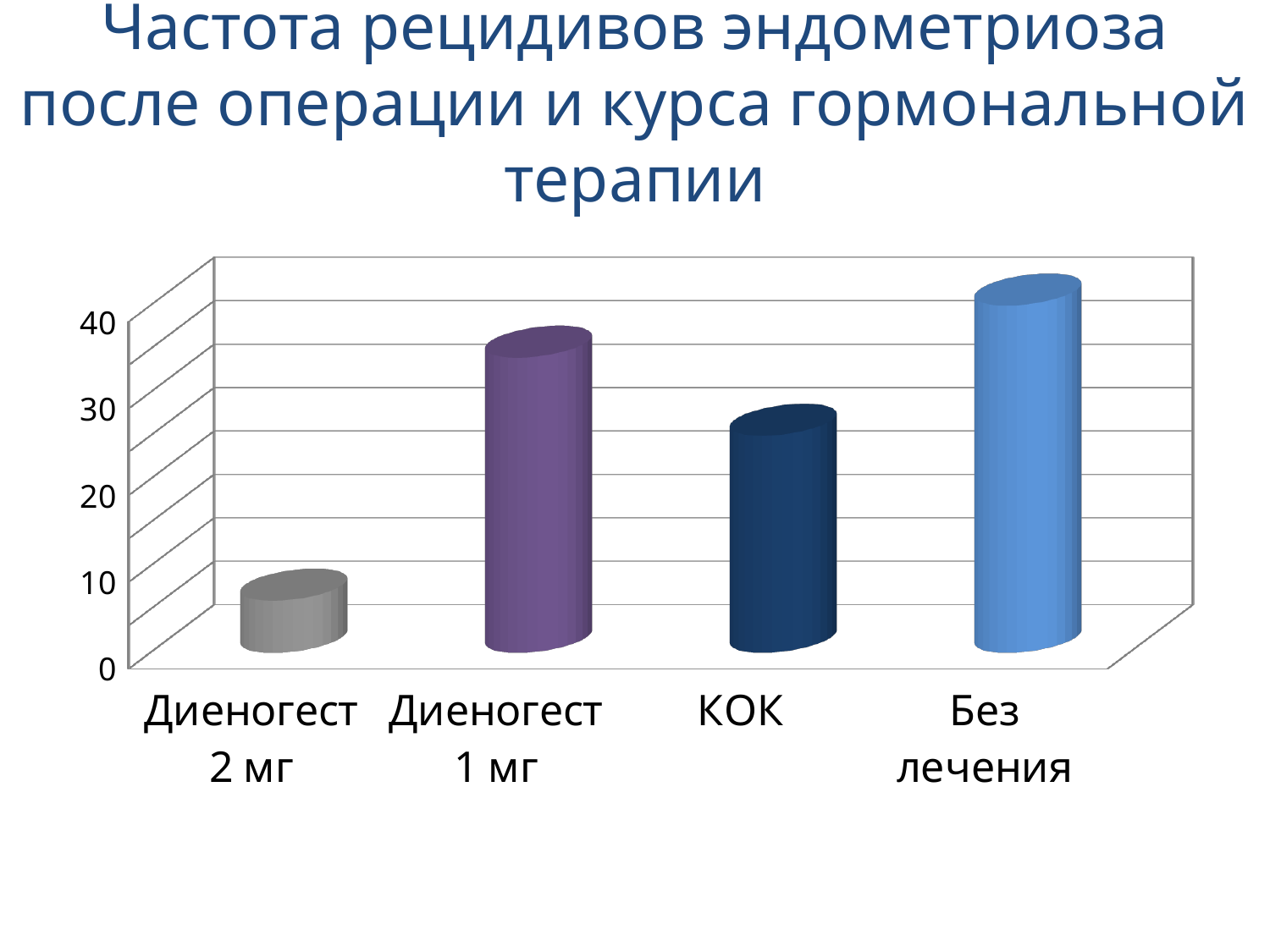
Is the value for КОК greater or less than 20? greater Which has a larger value, Диеногест 1 мг or КОК? Диеногест 1 мг Is the value for КОК greater or less than 30? less Which has a larger value, КОК or Без лечения? Без лечения Is the value for Диеногест 2 мг greater or less than 10? less What is the title of the slide containing the chart? Частота рецидивов эндометриоза после операции и курса гормональной терапии Which category has the lowest value in the chart? Диеногест 2 мг Which category has the highest value in the chart? Без лечения What kind of chart is shown on the slide? bar chart How many categories are shown on the x axis of the chart? 4